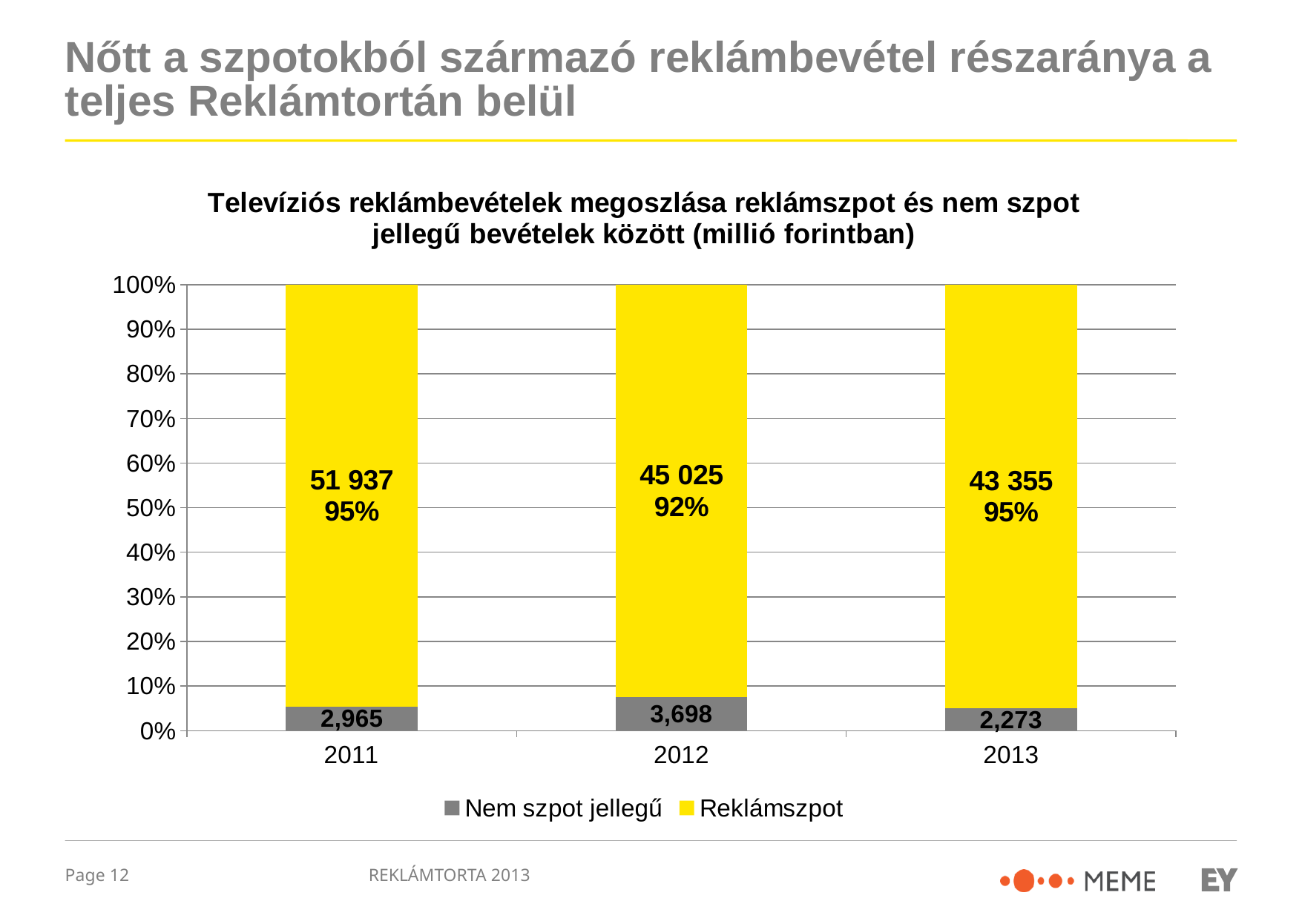
What is the Reklámszpot value for 2011? 51 937 What kind of chart is shown on the slide? Stacked bar chart What is the difference between the Reklámszpot values for 2011 and 2012? 6 912 What percentage share does Reklámszpot have in 2012? 92% Which is larger, the Nem szpot jellegű value for 2011 or for 2012? 2012 What is the Nem szpot jellegű value for 2012? 3,698 What is the difference between the Nem szpot jellegű values for 2012 and 2013? 1,425 How many series does the legend list? 2 Which year has the highest Reklámszpot value? 2011 Which year has the lowest Nem szpot jellegű value? 2013 What is the Nem szpot jellegű value for 2013? 2,273 How many years are shown on the x axis? 3